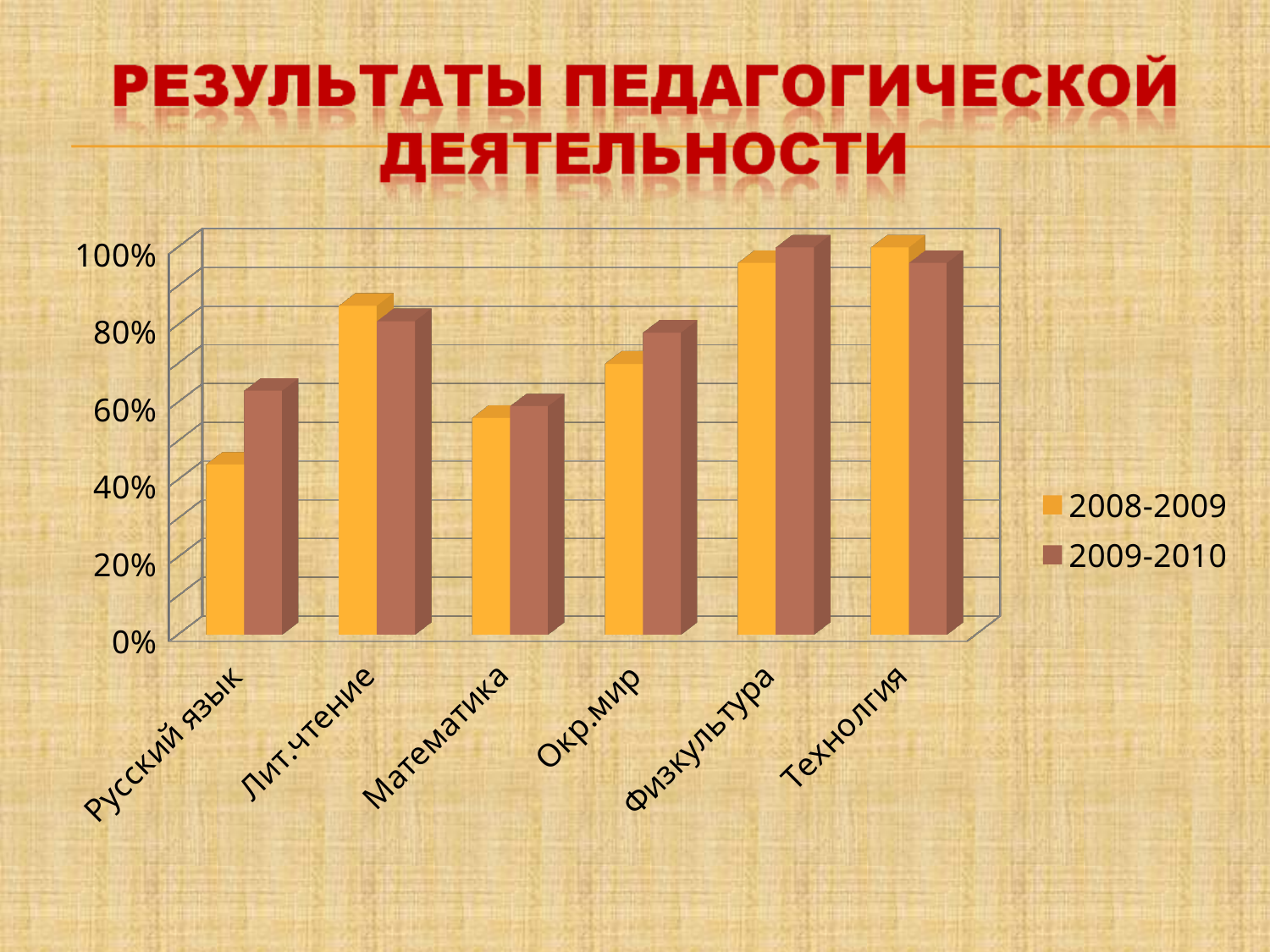
Is the 2009-2010 value for Русский язык greater or less than 40%? greater Is the 2008-2009 value for Русский язык greater or less than 60%? less Is the 2009-2010 value for Физкультура greater or less than 80%? greater How many series does the chart's legend list? 2 For Окр.мир, which series has the larger value, 2008-2009 or 2009-2010? 2009-2010 What is the title of the slide containing the chart? Результаты педагогической деятельности Which category has the lowest value for the 2008-2009 series? Русский язык How many categories are shown on the x axis of the chart? 6 What kind of chart is shown on the slide? Bar chart What are the two series listed in the chart's legend? 2008-2009 and 2009-2010 For Русский язык, which series has the larger value, 2008-2009 or 2009-2010? 2009-2010